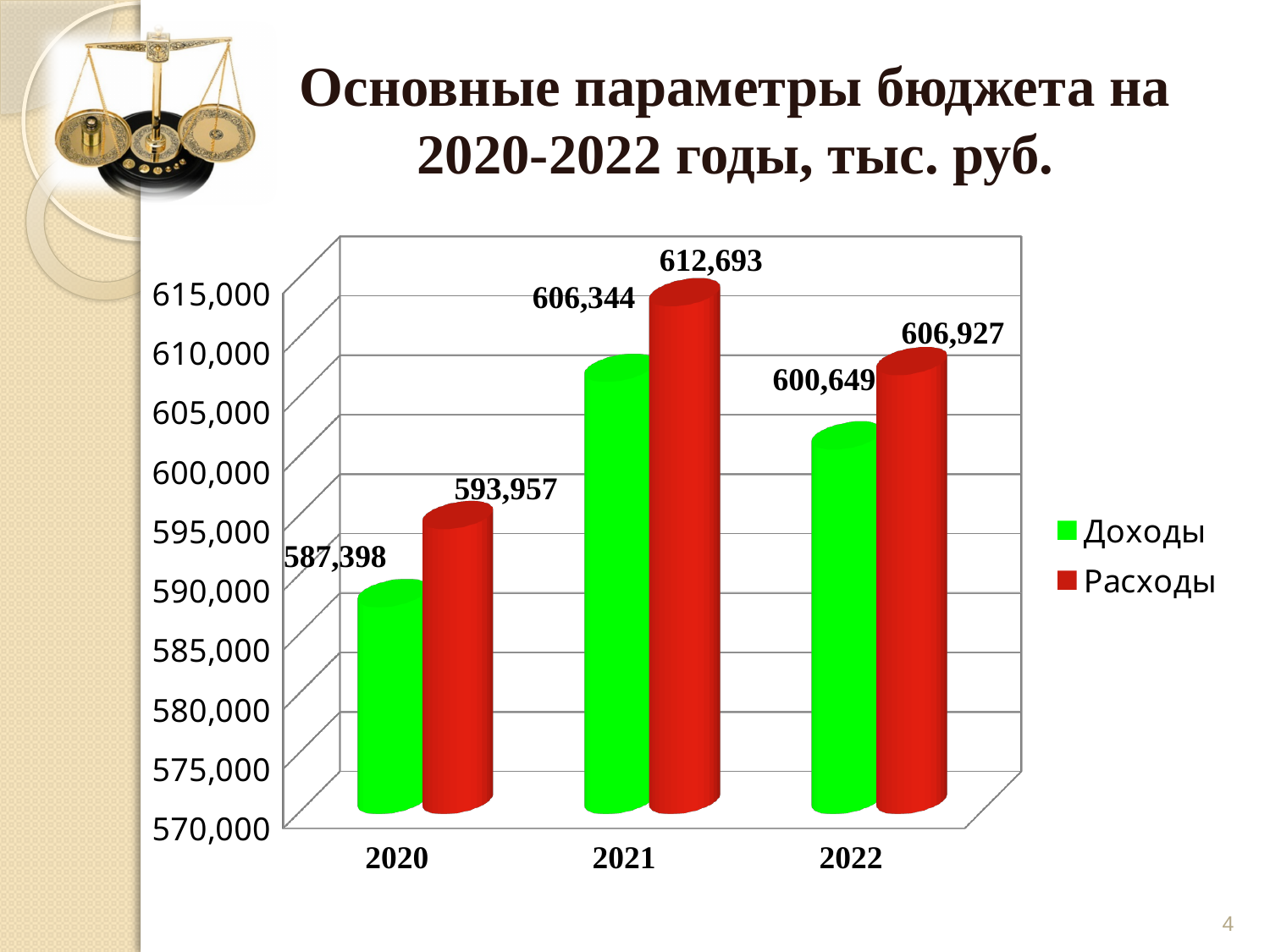
What is the value of Доходы for 2020? 587,398 In which year is Доходы highest? 2021 Which is larger in 2021, Доходы or Расходы? Расходы What is the value of Расходы for 2021? 612,693 What is the difference between Расходы and Доходы in 2020? 6,559 In which year is Расходы lowest? 2020 What kind of chart is shown on the slide? Bar chart How many series does the legend list? 2 What is the value of Расходы for 2022? 606,927 How many years are shown on the x axis? 3 Which colour represents Расходы in the chart? Red What is the difference between Расходы and Доходы in 2022? 6,278